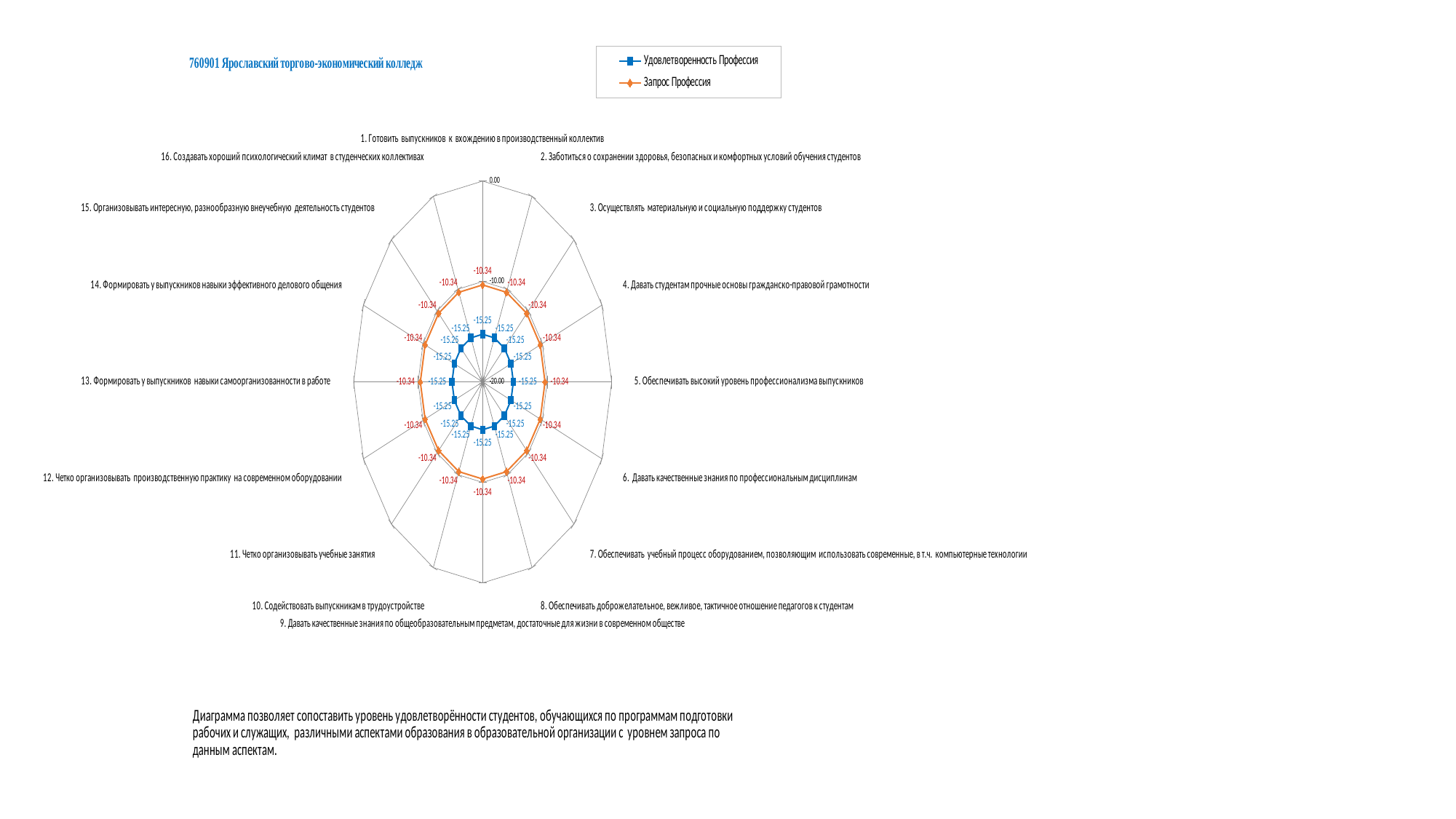
What is the title shown above the chart? 760901 Ярославский торгово-экономический колледж What kind of chart is shown on the slide? radar chart What is the value of the series "Запрос Профессия" for category "13. Формировать у выпускников навыки самоорганизованности в работе"? -10.34 What is the value of the series "Удовлетворенность Профессия" for category "5. Обеспечивать высокий уровень профессионализма выпускников"? -15.25 What is the value of the series "Запрос Профессия" for category "1. Готовить выпускников к вхождению в производственный коллектив"? -10.34 What is the value of the series "Удовлетворенность Профессия" for category "9. Давать качественные знания по общеобразовательным предметам, достаточные для жизни в современном обществе"? -15.25 How many categories (axes) does the radar chart have? 16 Which series has the larger value for category "11. Четко организовывать учебные занятия": "Удовлетворенность Профессия" or "Запрос Профессия"? Запрос Профессия What is the name of the series drawn with orange diamond markers? Запрос Профессия Is the value of "Удовлетворенность Профессия" for category "3. Осуществлять материальную и социальную поддержку студентов" greater or less than -10.00? less How many series does the legend list? 2 What is the difference between the "Запрос Профессия" value and the "Удовлетворенность Профессия" value for category "6. Давать качественные знания по профессиональным дисциплинам"? 4.91